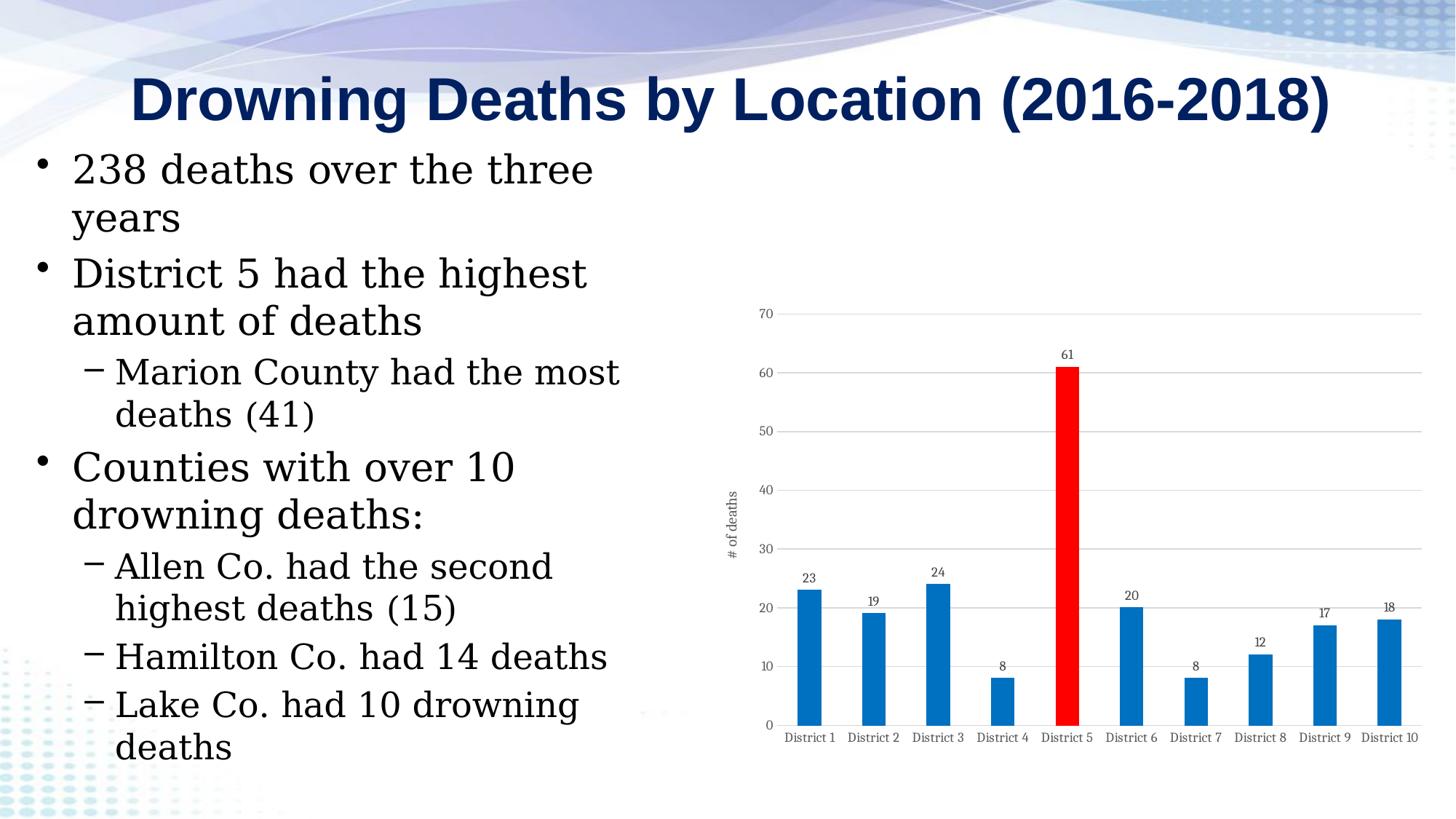
Which district has the highest number of deaths? District 5 What is the number of deaths for District 3? 24 What is the difference in deaths between District 1 and District 2? 4 Which districts have the lowest number of deaths? District 4 and District 7 How many districts are shown on the chart? 10 What is the number of deaths for District 9? 17 Which bar is coloured red instead of blue? District 5 What is the label of the vertical axis? # of deaths Which has more deaths, District 6 or District 8? District 6 What type of chart is shown on the slide? Bar chart What is the number of deaths for District 5? 61 What is the difference in deaths between District 5 and District 3? 37